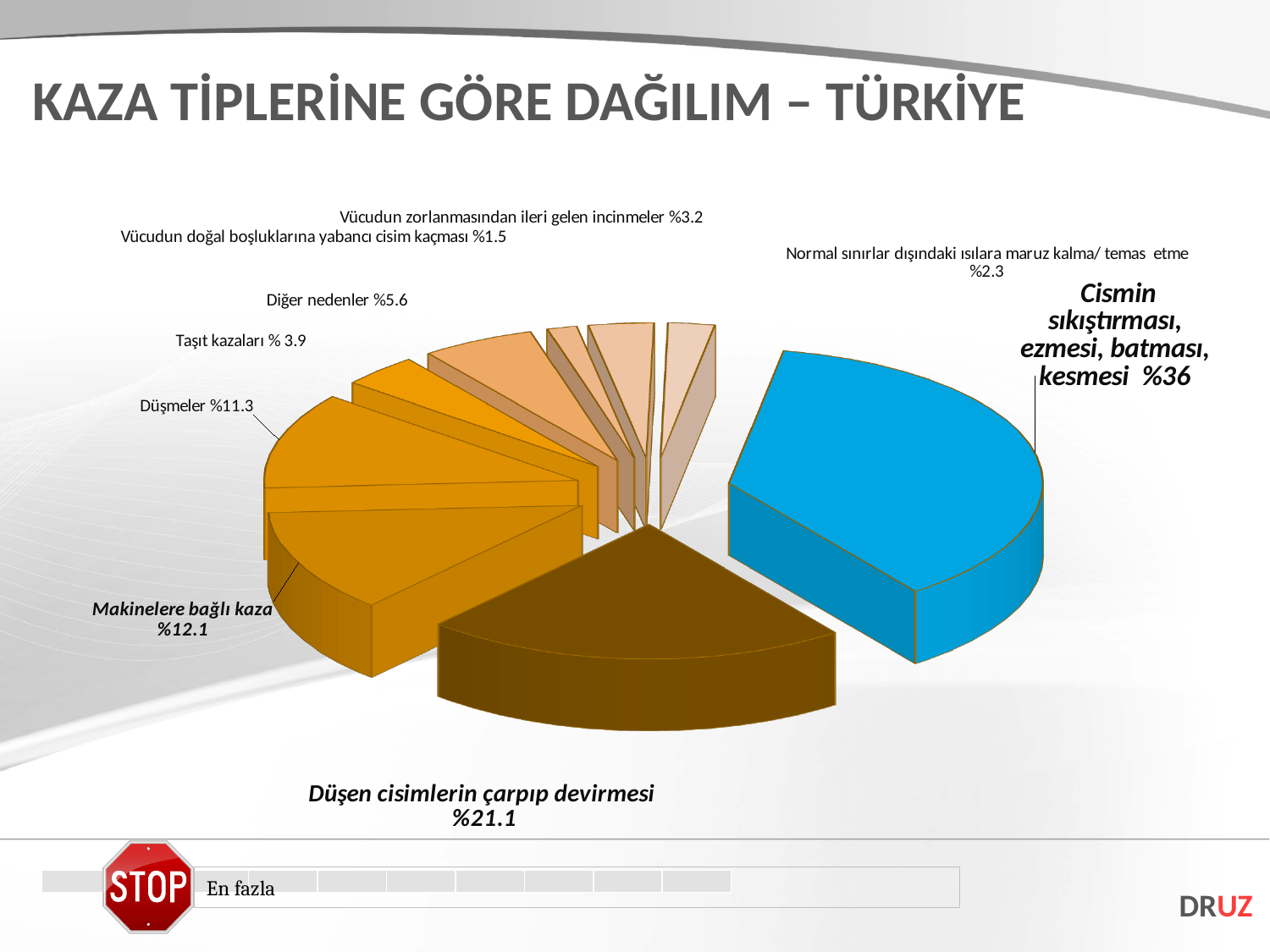
Which category has the largest share of the pie? Cismin sıkıştırması, ezmesi, batması, kesmesi What share does the slice 'Cismin sıkıştırması, ezmesi, batması, kesmesi' have? %36 Which is larger, the share for 'Taşıt kazaları' or the share for 'Diğer nedenler'? Diğer nedenler What is the value shown for 'Düşen cisimlerin çarpıp devirmesi'? %21.1 Which category has the smallest share of the pie? Vücudun doğal boşluklarına yabancı cisim kaçması What is the difference between the shares of 'Cismin sıkıştırması, ezmesi, batması, kesmesi' and 'Düşen cisimlerin çarpıp devirmesi'? 14.9 percentage points What is the title of the slide containing the chart? KAZA TİPLERİNE GÖRE DAĞILIM – TÜRKİYE What is the value shown for 'Vücudun doğal boşluklarına yabancı cisim kaçması'? %1.5 What is the value shown for 'Makinelere bağlı kaza'? %12.1 What is the value shown for 'Düşmeler'? %11.3 What is the value shown for 'Diğer nedenler'? %5.6 What kind of chart is shown on the slide? pie chart